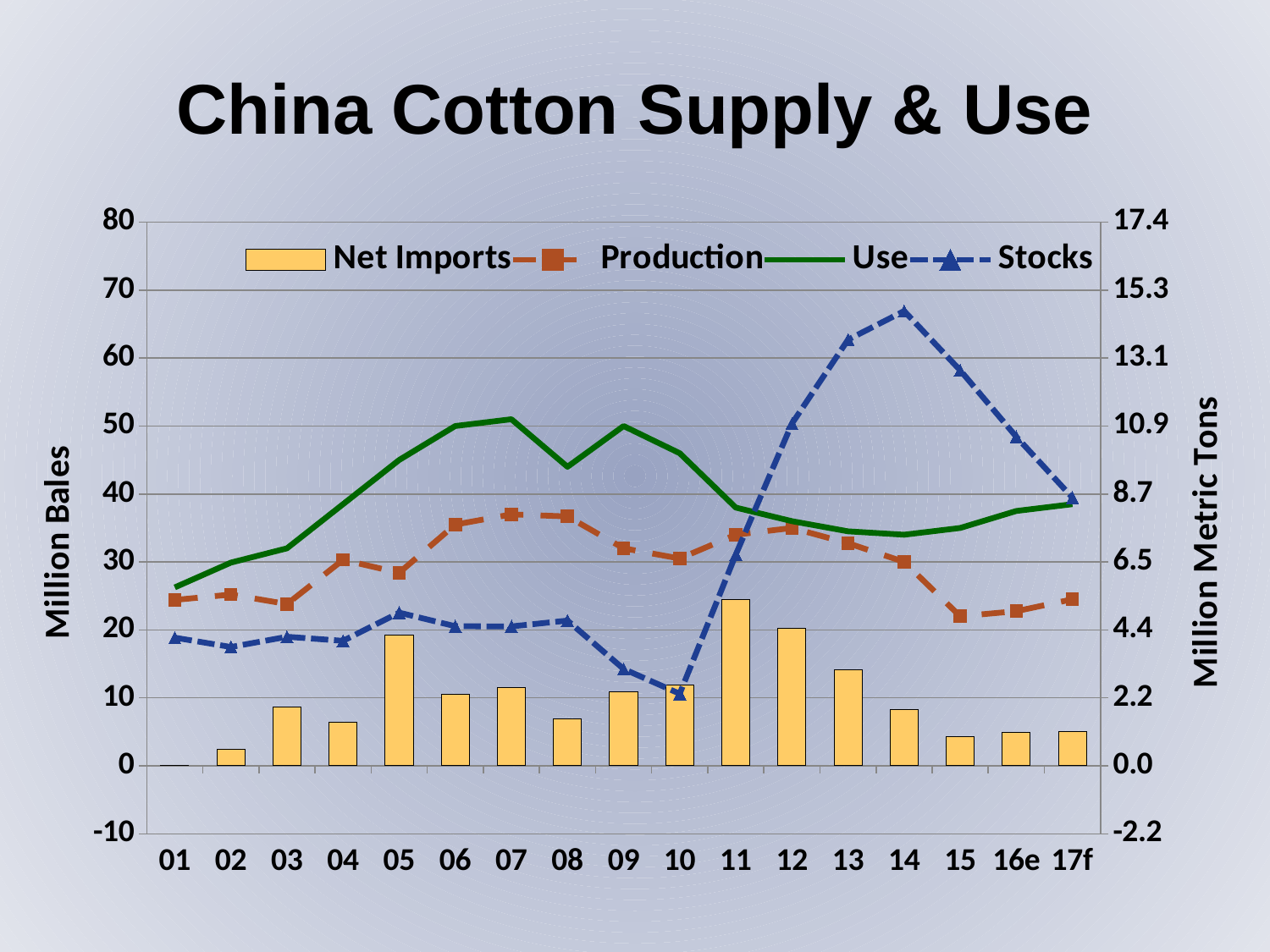
What is the label of the left vertical axis? Million Bales Which is larger in 07, Use or Production? Use Do Stocks rise or fall from 14 to 17f? Fall How many years are shown along the x axis? 17 What kind of chart is shown on the slide? A combination bar and line chart In which year are Net Imports highest? 11 Is the value for Stocks in 14 greater or less than 60 million bales? greater Is the value for Production in 15 greater or less than 30 million bales? less Is the value for Net Imports in 11 greater or less than 20 million bales? greater In which year are Stocks lowest? 10 In which year are Stocks highest? 14 How many series does the legend list? 4